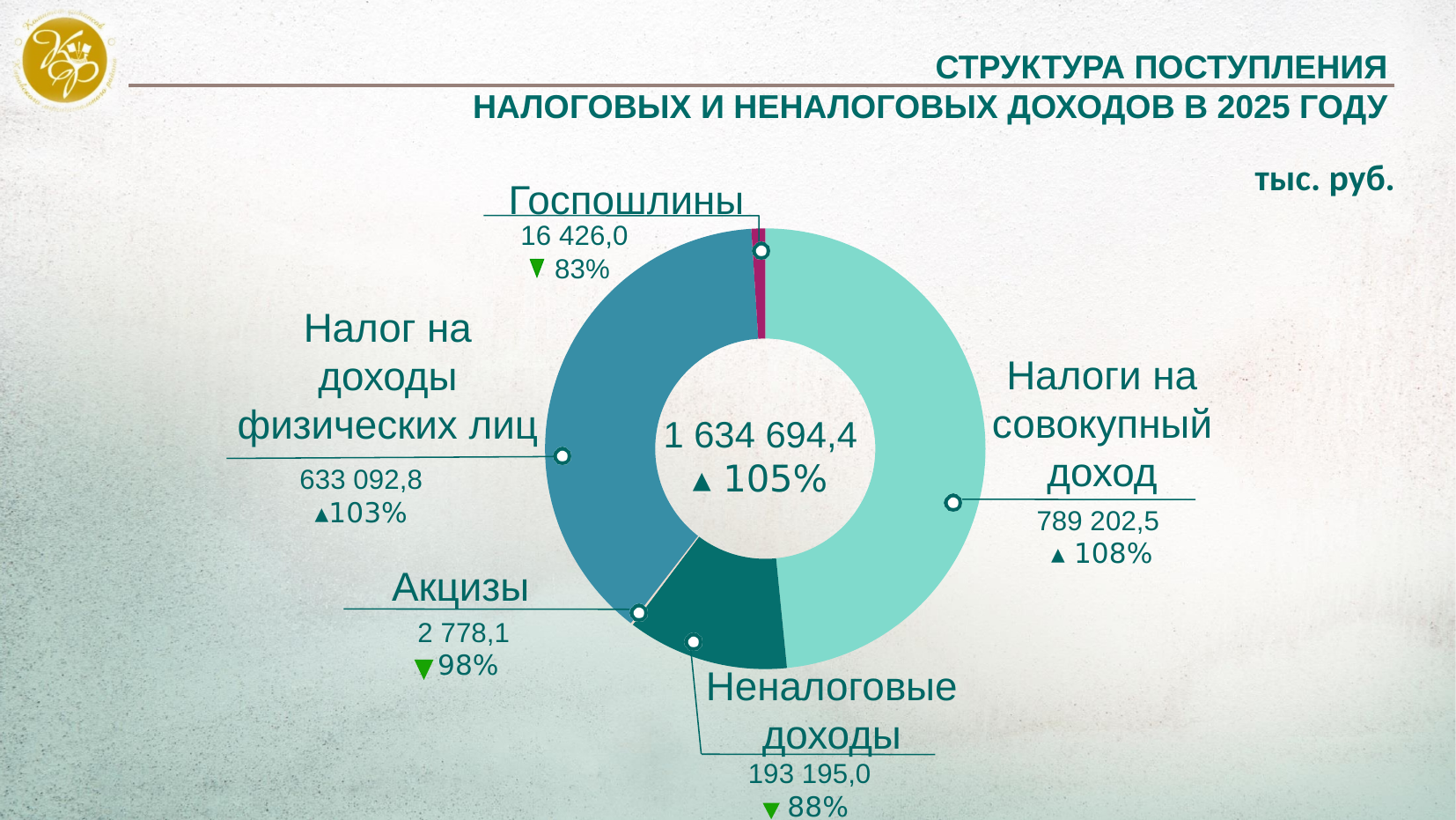
What is the difference between Налоги на совокупный доход and Налог на доходы физических лиц? 156 109,7 Which category has the lowest value? Акцизы Which category has the highest value? Налоги на совокупный доход How many categories are shown in the chart? 5 What percentage is shown next to Госпошлины? 83% What total value is shown in the centre of the chart? 1 634 694,4 What kind of chart is shown on the slide? Pie (donut) chart What is the value for Неналоговые доходы? 193 195,0 Which is larger, Неналоговые доходы or Госпошлины? Неналоговые доходы What is the value for Налог на доходы физических лиц? 633 092,8 What is the value for Налоги на совокупный доход? 789 202,5 What is the value for Акцизы? 2 778,1